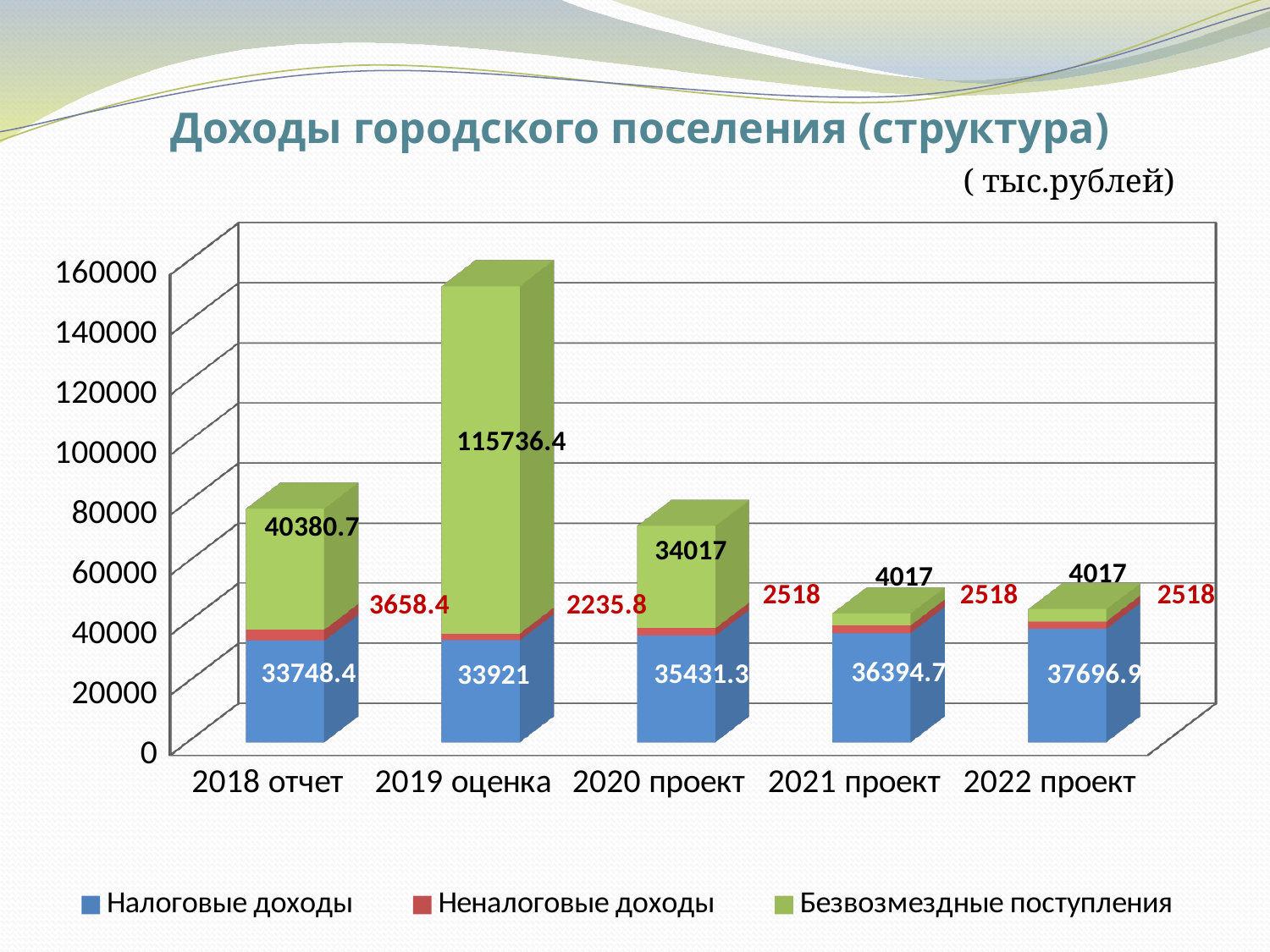
What type of chart is shown on the slide? stacked bar chart What is the difference between Налоговые доходы for 2022 проект and 2018 отчет? 3948.5 Which is larger: Безвозмездные поступления for 2018 отчет or for 2020 проект? 2018 отчет Do the values of Налоговые доходы rise or fall from 2018 отчет to 2022 проект? rise What is the total of the stacked bar for 2019 оценка? 151893.2 What is the value of Неналоговые доходы for 2020 проект? 2518 What is the value of Налоговые доходы for 2018 отчет? 33748.4 Which category has the lowest value of Налоговые доходы? 2018 отчет How many categories are shown on the x axis? 5 What is the value of Безвозмездные поступления for 2019 оценка? 115736.4 Which category has the highest value of Безвозмездные поступления? 2019 оценка How many series does the legend list? 3